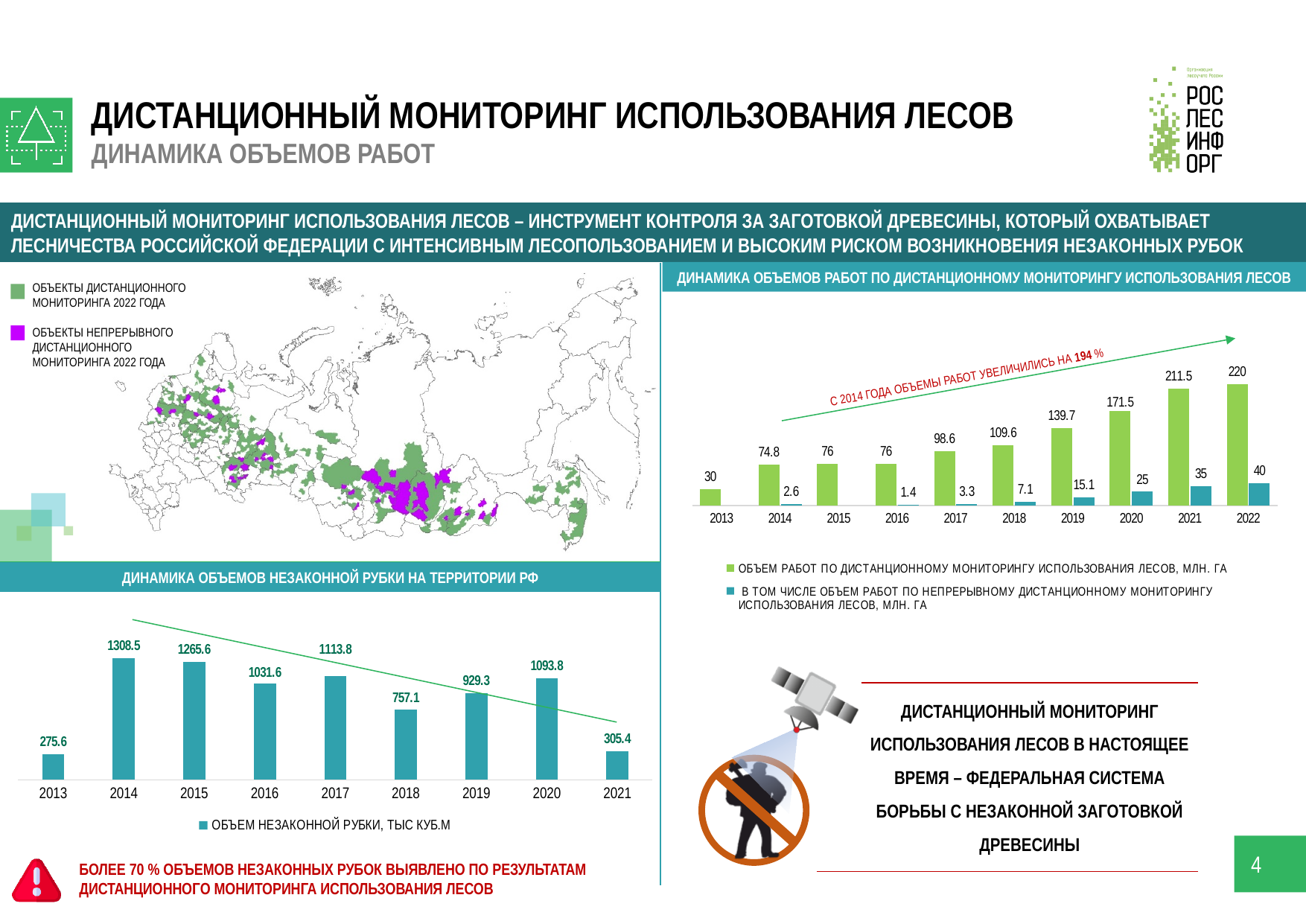
In the chart 'ДИНАМИКА ОБЪЕМОВ НЕЗАКОННОЙ РУБКИ НА ТЕРРИТОРИИ РФ', how many years are shown on the x axis? 9 In the chart 'ДИНАМИКА ОБЪЕМОВ РАБОТ ПО ДИСТАНЦИОННОМУ МОНИТОРИНГУ ИСПОЛЬЗОВАНИЯ ЛЕСОВ', does the green series rise or fall from 2013 to 2022? rise In the chart 'ДИНАМИКА ОБЪЕМОВ РАБОТ ПО ДИСТАНЦИОННОМУ МОНИТОРИНГУ ИСПОЛЬЗОВАНИЯ ЛЕСОВ', what is the value of the teal series (непрерывный мониторинг) for 2022? 40 What type of chart is 'ДИНАМИКА ОБЪЕМОВ РАБОТ ПО ДИСТАНЦИОННОМУ МОНИТОРИНГУ ИСПОЛЬЗОВАНИЯ ЛЕСОВ'? bar chart In the chart 'ДИНАМИКА ОБЪЕМОВ НЕЗАКОННОЙ РУБКИ НА ТЕРРИТОРИИ РФ', which is larger, the value for 2017 or the value for 2018? 2017 In the chart 'ДИНАМИКА ОБЪЕМОВ НЕЗАКОННОЙ РУБКИ НА ТЕРРИТОРИИ РФ', what is the difference between the values for 2020 and 2021? 788.4 In the chart 'ДИНАМИКА ОБЪЕМОВ РАБОТ ПО ДИСТАНЦИОННОМУ МОНИТОРИНГУ ИСПОЛЬЗОВАНИЯ ЛЕСОВ', what is the value of the green series (ОБЪЕМ РАБОТ ПО ДИСТАНЦИОННОМУ МОНИТОРИНГУ) for 2019? 139.7 In the chart 'ДИНАМИКА ОБЪЕМОВ НЕЗАКОННОЙ РУБКИ НА ТЕРРИТОРИИ РФ', which year has the highest value? 2014 In the chart 'ДИНАМИКА ОБЪЕМОВ НЕЗАКОННОЙ РУБКИ НА ТЕРРИТОРИИ РФ', which year has the lowest value? 2013 In the chart 'ДИНАМИКА ОБЪЕМОВ НЕЗАКОННОЙ РУБКИ НА ТЕРРИТОРИИ РФ', what is the value for 2014? 1308.5 In the chart 'ДИНАМИКА ОБЪЕМОВ РАБОТ ПО ДИСТАНЦИОННОМУ МОНИТОРИНГУ ИСПОЛЬЗОВАНИЯ ЛЕСОВ', what is the difference between the green series values for 2022 and 2013? 190 In the chart 'ДИНАМИКА ОБЪЕМОВ РАБОТ ПО ДИСТАНЦИОННОМУ МОНИТОРИНГУ ИСПОЛЬЗОВАНИЯ ЛЕСОВ', how many series does the legend list? 2